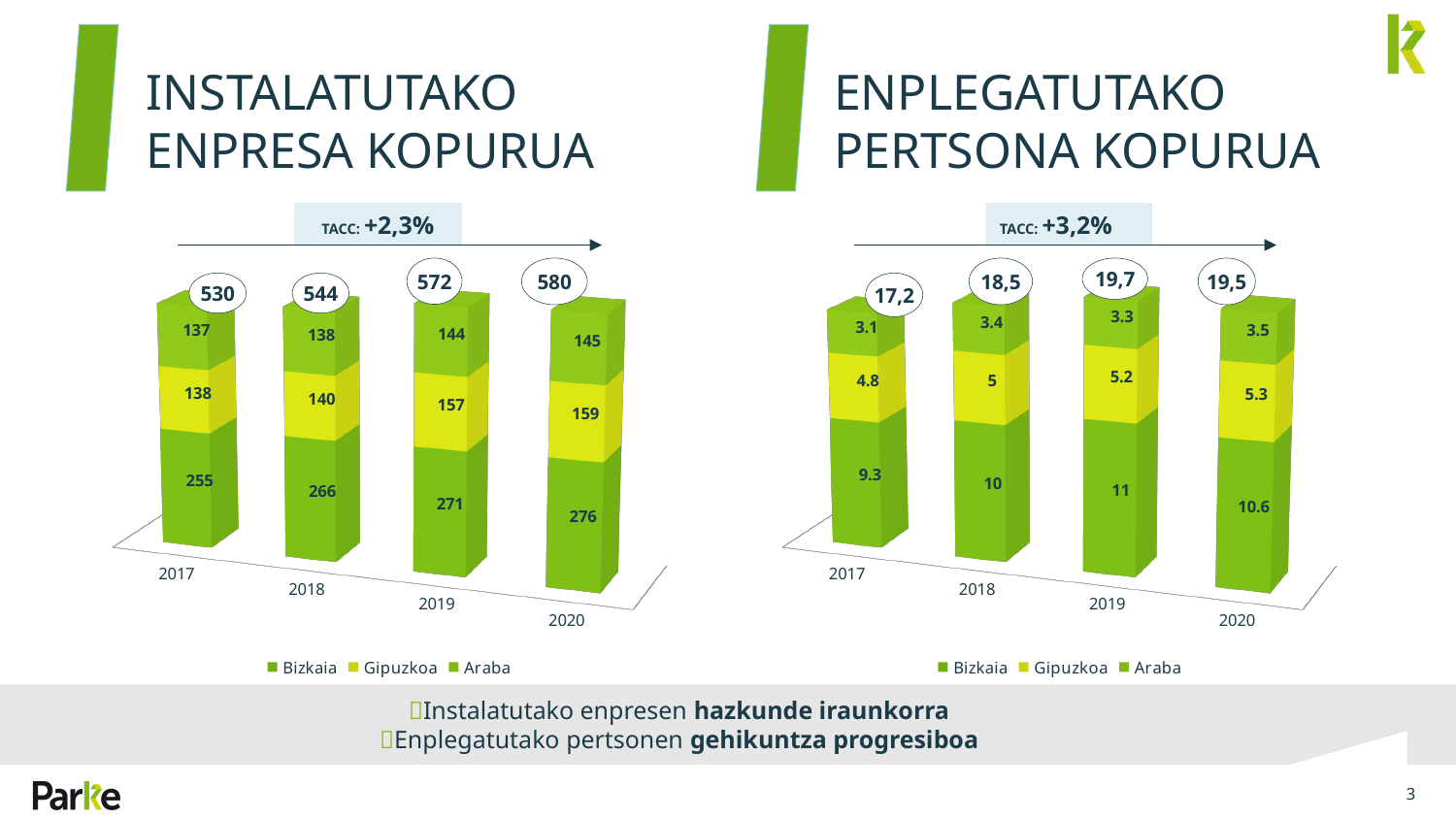
In the ENPLEGATUTAKO PERTSONA KOPURUA chart, is the Araba value larger in 2018 or in 2020? 2020 In the ENPLEGATUTAKO PERTSONA KOPURUA chart, what is the total shown above the 2017 bar? 17,2 In the INSTALATUTAKO ENPRESA KOPURUA chart, do the totals rise or fall from 2017 to 2020? rise In the INSTALATUTAKO ENPRESA KOPURUA chart, what is the value for Bizkaia in 2020? 276 In the ENPLEGATUTAKO PERTSONA KOPURUA chart, which year has the lowest total? 2017 What kind of chart is the INSTALATUTAKO ENPRESA KOPURUA chart? stacked bar chart In the INSTALATUTAKO ENPRESA KOPURUA chart, which year has the highest total? 2020 How many series does the legend of the ENPLEGATUTAKO PERTSONA KOPURUA chart list? 3 In the INSTALATUTAKO ENPRESA KOPURUA chart, what TACC value is shown? +2,3% In the INSTALATUTAKO ENPRESA KOPURUA chart, what is the difference between the Gipuzkoa values for 2019 and 2018? 17 In the INSTALATUTAKO ENPRESA KOPURUA chart, what is the total shown above the 2019 bar? 572 In the ENPLEGATUTAKO PERTSONA KOPURUA chart, what is the value for Bizkaia in 2019? 11